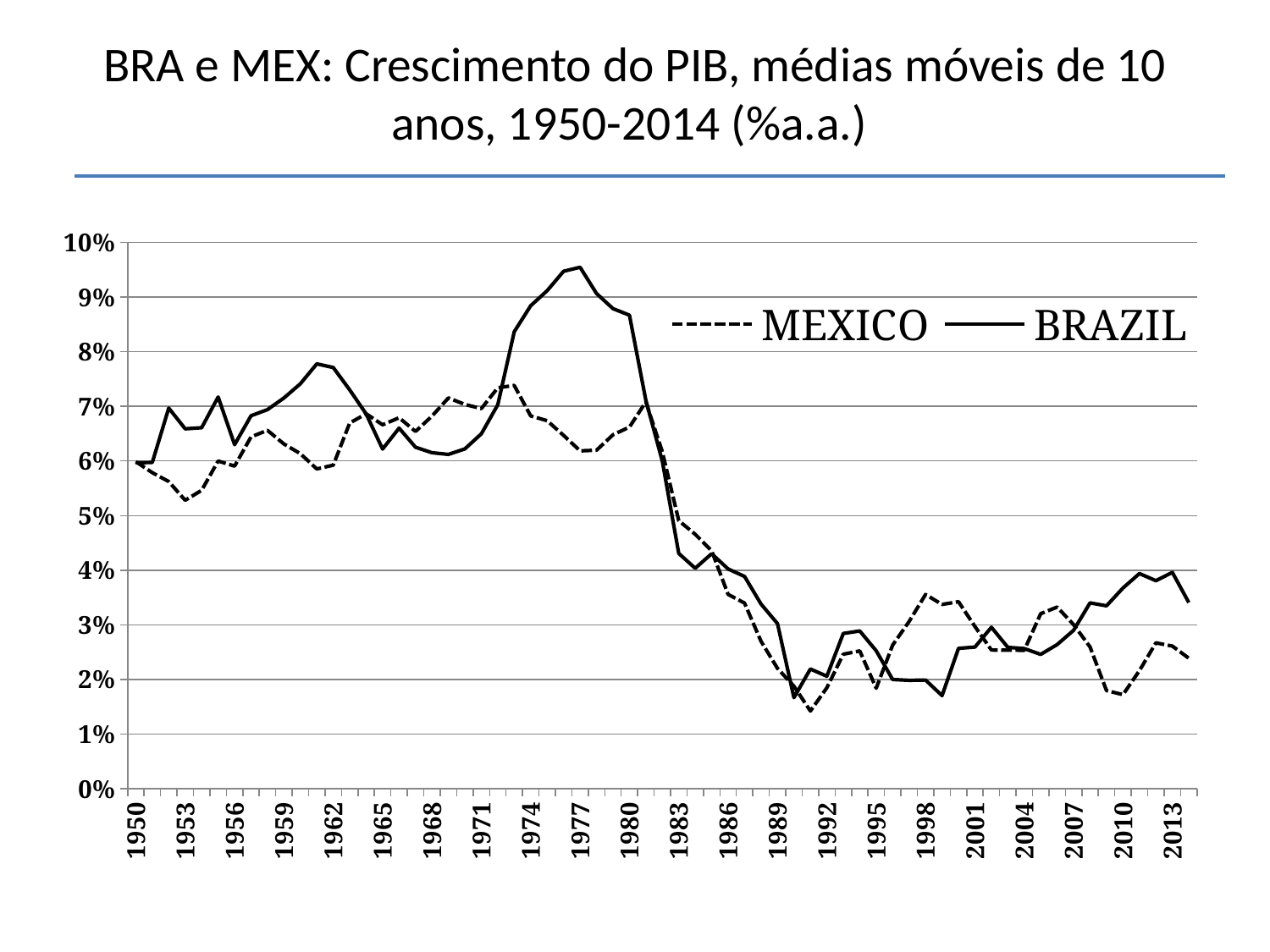
Is the value for BRAZIL in 1990 greater or less than 2%? less In 1998, which series has the higher value, MEXICO or BRAZIL? MEXICO Is the value for BRAZIL in 1977 greater or less than 9%? greater How many series does the legend list? 2 In 1977, which series has the higher value, MEXICO or BRAZIL? BRAZIL Which series is drawn with a dashed line? MEXICO Is the value for BRAZIL in 2013 greater or less than 3%? greater Does the BRAZIL series rise or fall between 1977 and 1990? fall What kind of chart is shown on the slide? Line chart Which two series are listed in the chart legend? MEXICO and BRAZIL